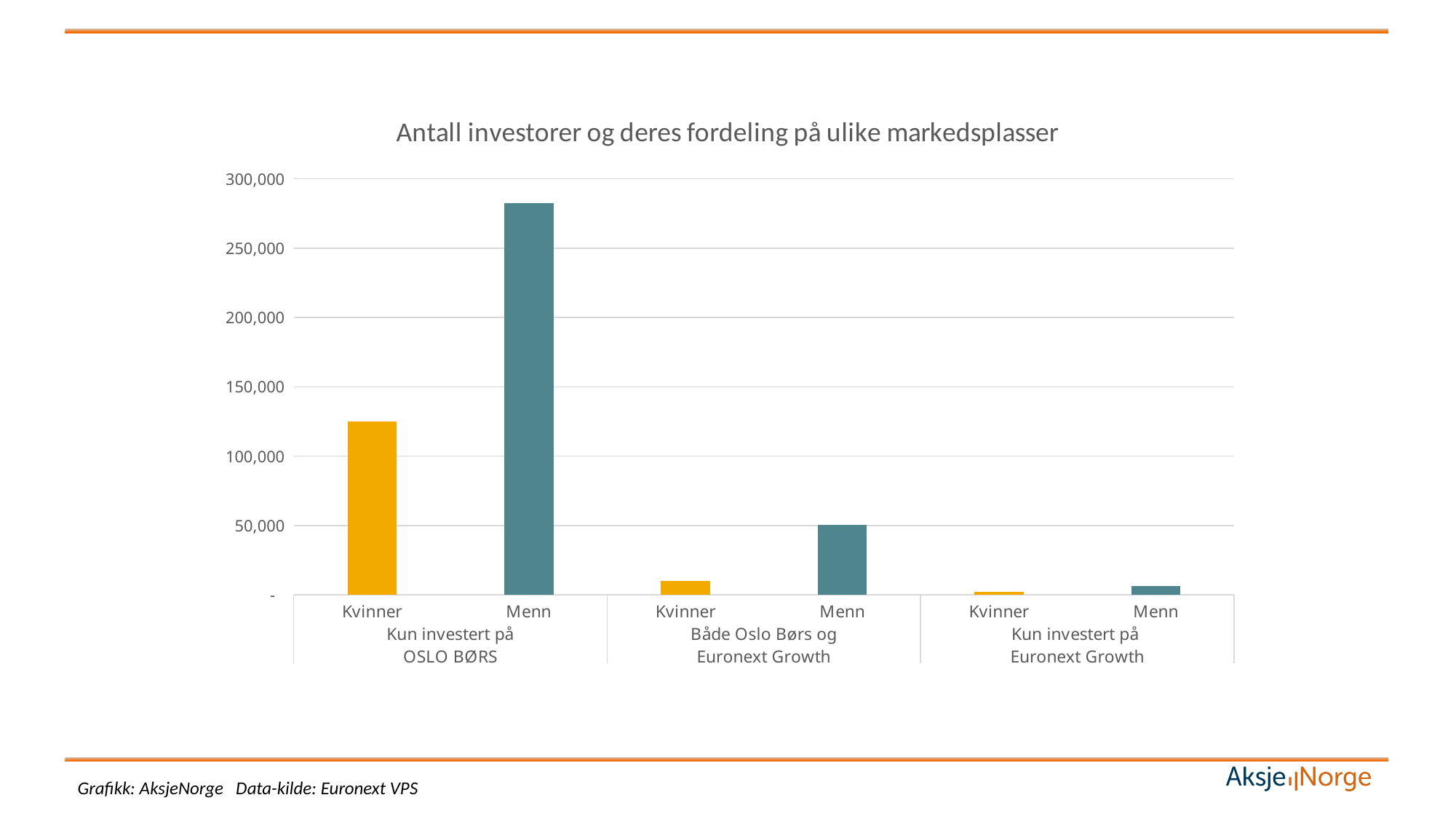
How many market-place groups are shown along the x axis? 3 How many bars are plotted in the chart? 6 Is the value for Kvinner under Kun investert på OSLO BØRS greater or less than 100,000? greater What colour are the Kvinner bars in the chart? yellow/orange Which bar is the lowest in the chart? Kvinner, Kun investert på Euronext Growth Is the value for Kvinner under Kun investert på OSLO BØRS greater or less than 150,000? less Is the value for Menn under Kun investert på OSLO BØRS greater or less than 250,000? greater What is the title of the chart? Antall investorer og deres fordeling på ulike markedsplasser Within the group Både Oslo Børs og Euronext Growth, which is larger: Kvinner or Menn? Menn What kind of chart is shown on the slide? bar chart Which bar is the highest in the chart? Menn, Kun investert på OSLO BØRS